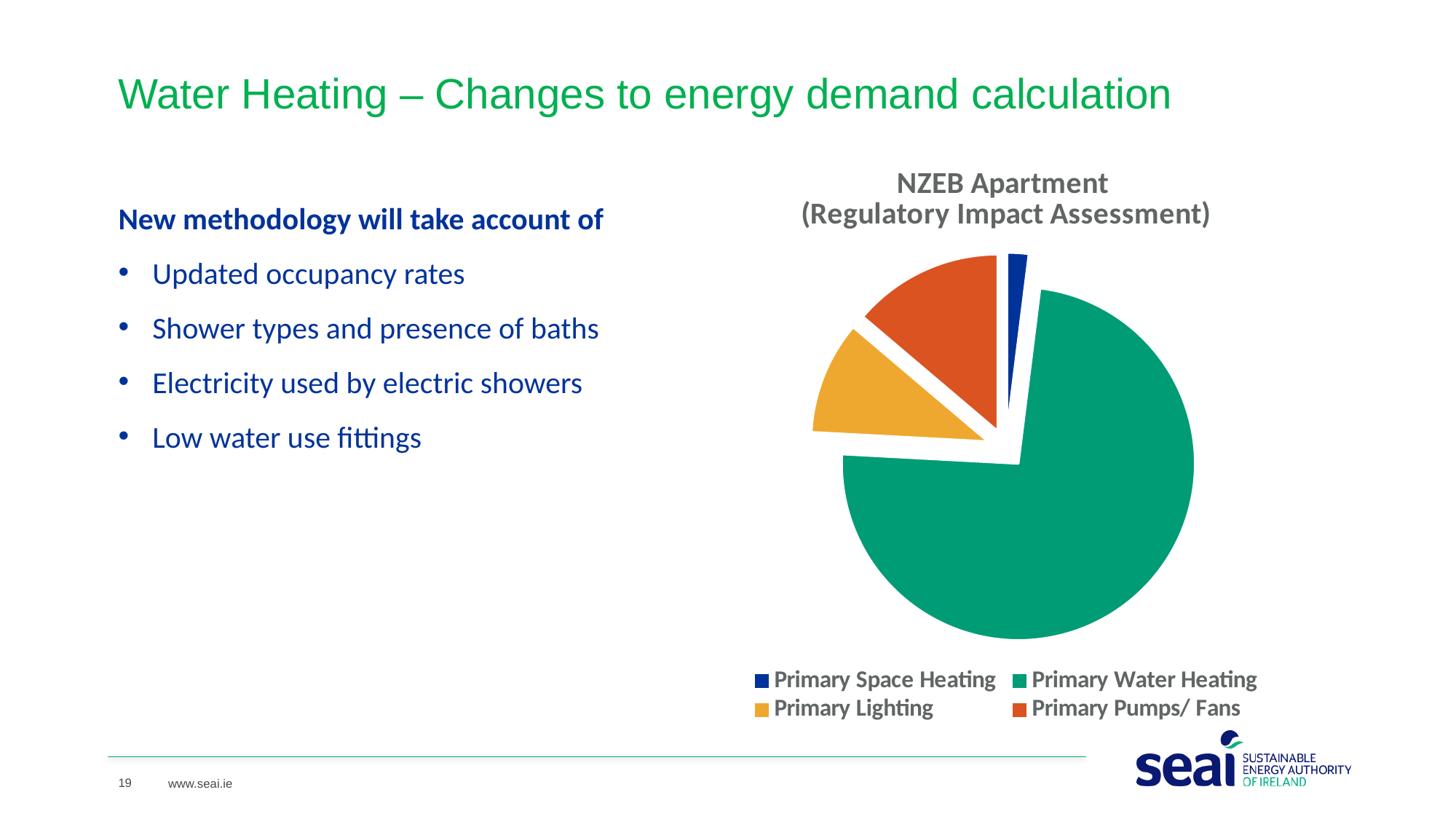
How many slices does the pie chart have? 4 What kind of chart is shown on the slide? pie chart Which is larger, the slice for Primary Pumps/ Fans or the slice for Primary Space Heating? Primary Pumps/ Fans What is the title of the chart? NZEB Apartment (Regulatory Impact Assessment) Which category has the smallest slice of the pie? Primary Space Heating Does Primary Water Heating account for more or less than half of the pie? more Which is larger, the slice for Primary Water Heating or the slice for Primary Lighting? Primary Water Heating How many entries does the chart legend list? 4 Which category has the largest slice of the pie? Primary Water Heating Which colour represents Primary Water Heating in the pie chart? green